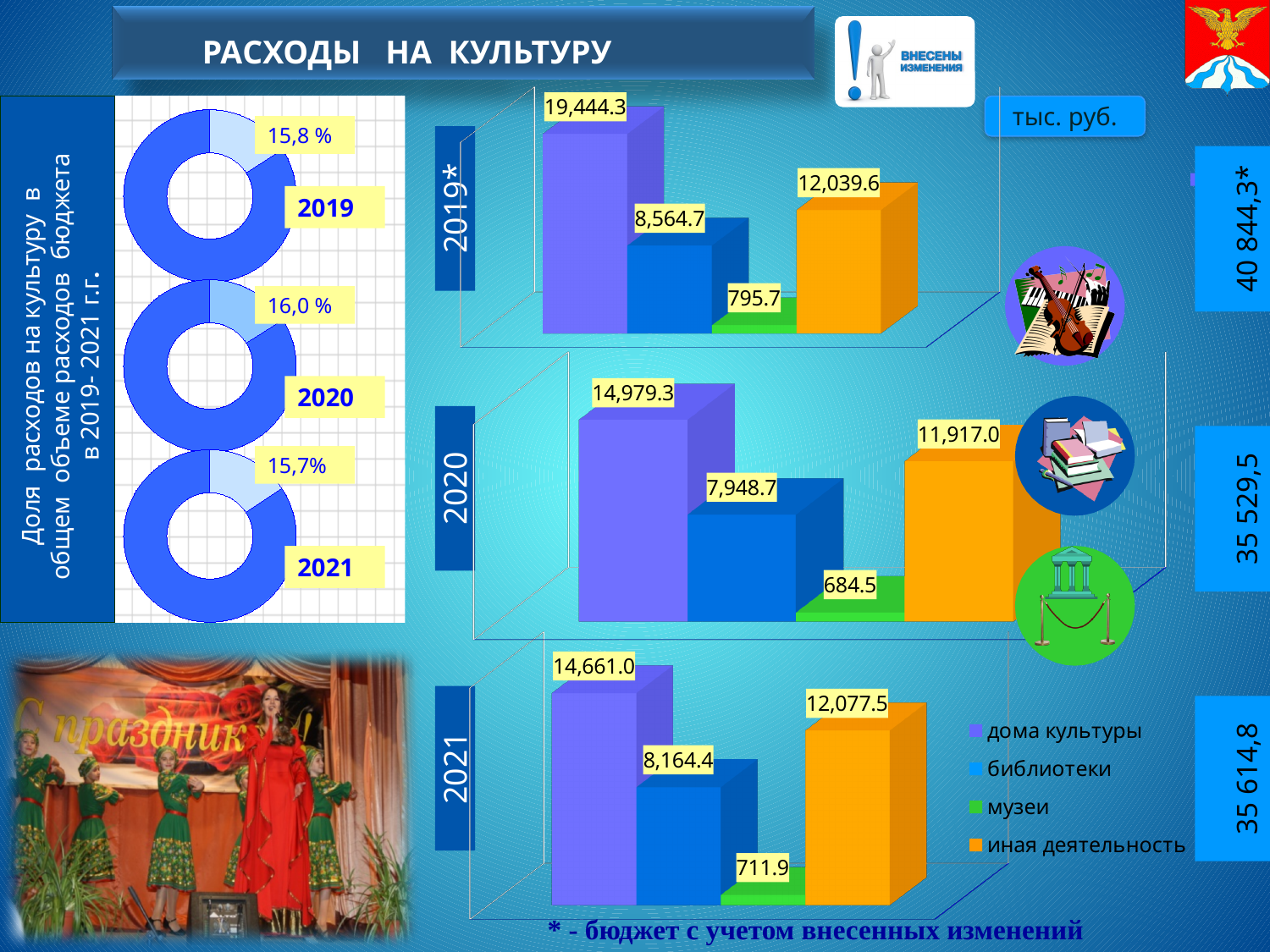
In the 2019* bar chart, what is the value for дома культуры? 19,444.3 What type of chart is used to show the 2019*, 2020 and 2021 expenditure breakdowns? bar chart In the 2020 bar chart, what is the value for иная деятельность? 11,917.0 In the 2021 bar chart, what is the value for библиотеки? 8,164.4 In the 2019* bar chart, which category has the highest value? дома культуры In the donut chart for 2020, what share of total budget expenses goes to culture? 16,0 % In the 2020 bar chart, which category has the lowest value? музеи How many series does the legend of the bar charts list? 4 In the 2021 bar chart, what is the value for музеи? 711.9 In the donut chart for 2021, what share of total budget expenses goes to culture? 15,7% In the 2020 bar chart, which is larger: библиотеки or иная деятельность? иная деятельность In the 2021 bar chart, what is the difference between дома культуры and иная деятельность? 2,583.5